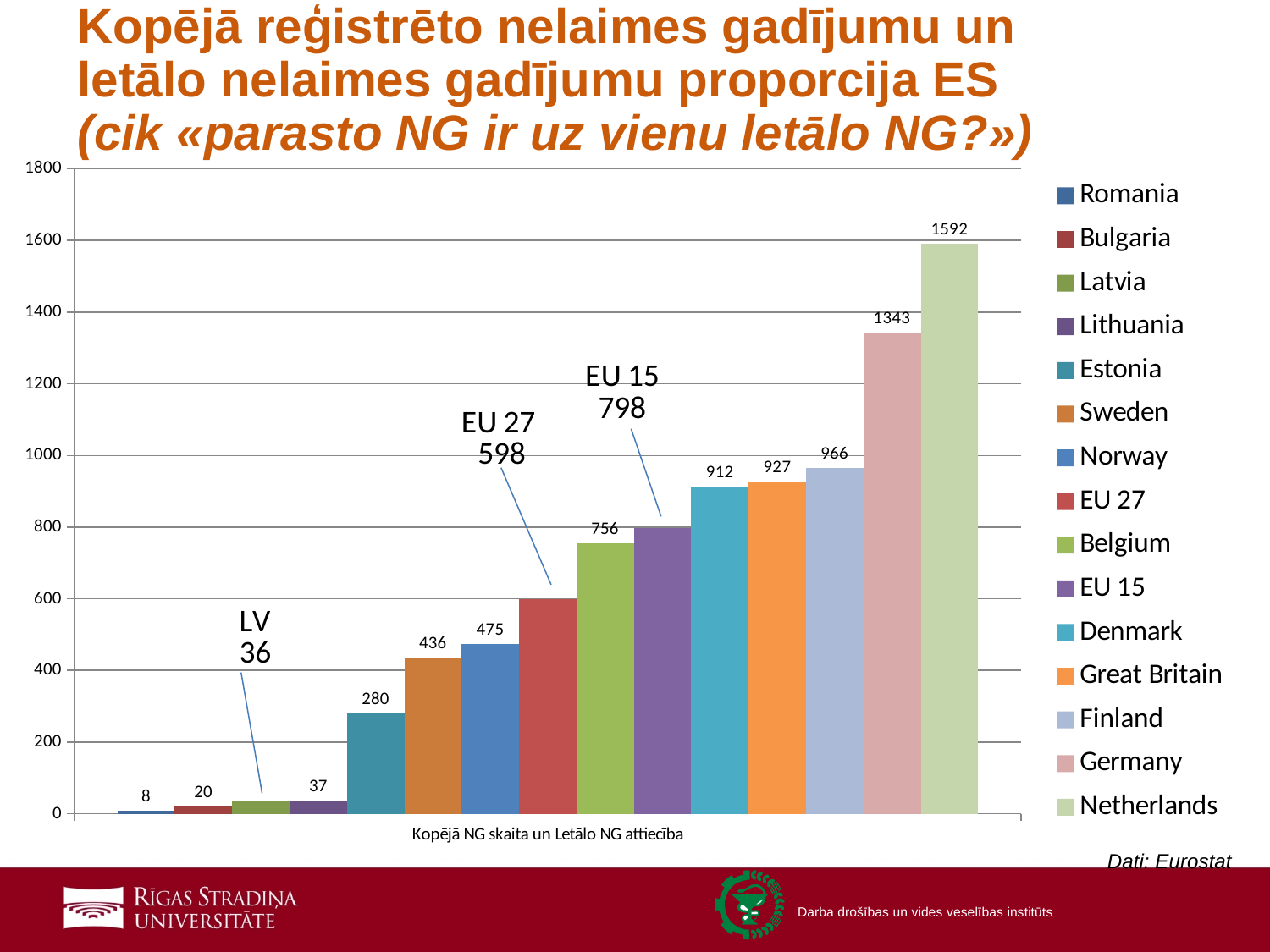
What kind of chart is shown on the slide? Bar chart What is the difference between the values for Netherlands and Germany? 249 Do the bar values rise or fall from left to right? Rise Which country has the lowest value? Romania Which has a larger value, Denmark or Great Britain? Great Britain What value is shown for EU 15? 798 What value is shown for EU 27? 598 What is the value for Germany? 1343 What is the value for Estonia? 280 How many entries does the legend list? 15 Which country has the highest value? Netherlands What is the value for Netherlands? 1592